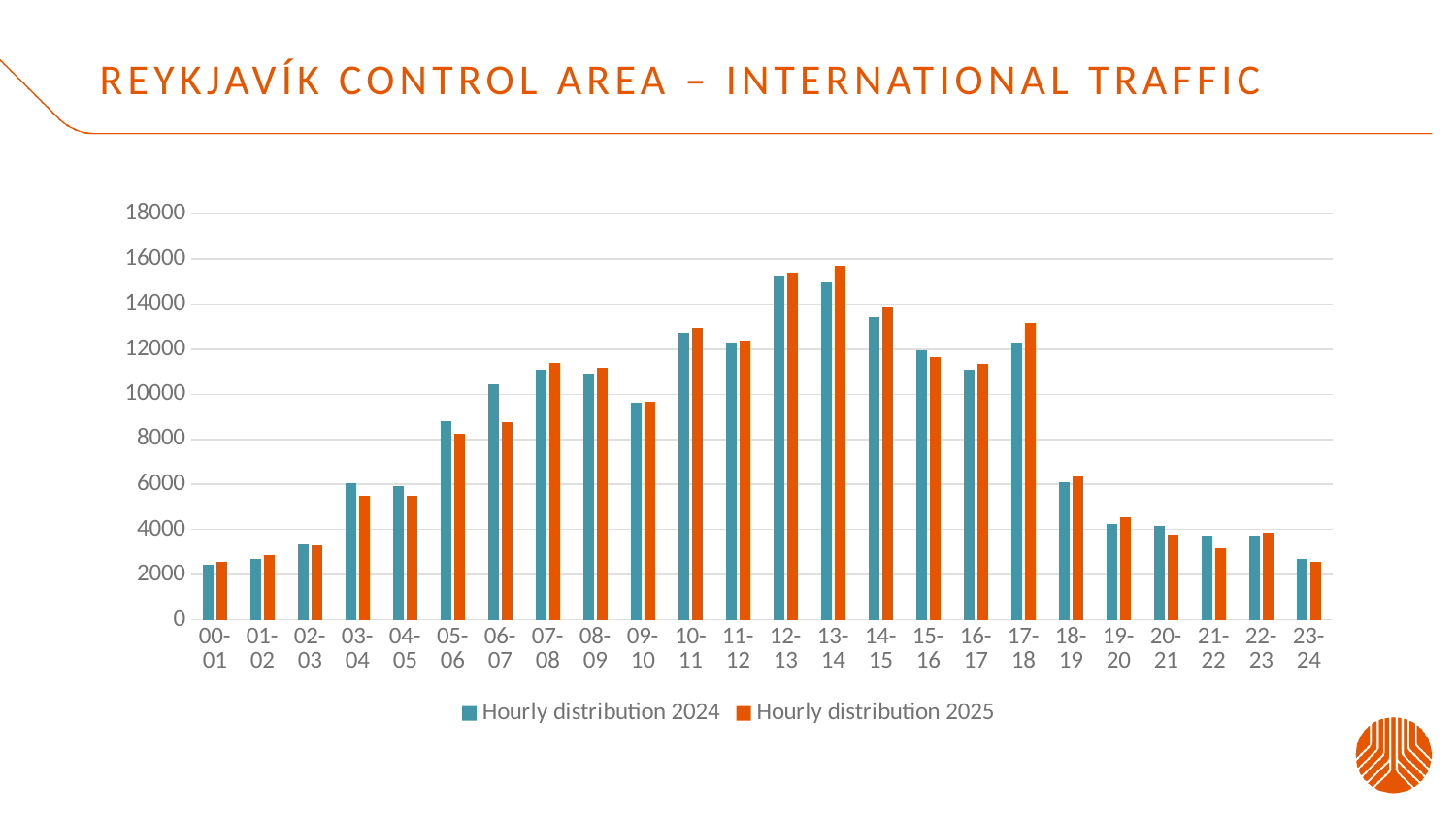
How many hourly categories are shown on the x axis? 24 Do the values for Hourly distribution 2024 rise or fall from 00-01 to 03-04? rise What kind of chart is shown on the slide? Bar chart How many series does the legend list? 2 Is the value for Hourly distribution 2025 at 06-07 greater or less than 10000? less Which hour has the lowest value for Hourly distribution 2024? 00-01 Which hour has the highest value for Hourly distribution 2025? 13-14 For the hour 17-18, which series is larger, Hourly distribution 2024 or Hourly distribution 2025? Hourly distribution 2025 What is the title of the slide? Reykjavík Control Area – International Traffic Is the value for Hourly distribution 2024 at 12-13 greater or less than 14000? greater Which hour has the highest value for Hourly distribution 2024? 12-13 For the hour 06-07, which series is larger, Hourly distribution 2024 or Hourly distribution 2025? Hourly distribution 2024